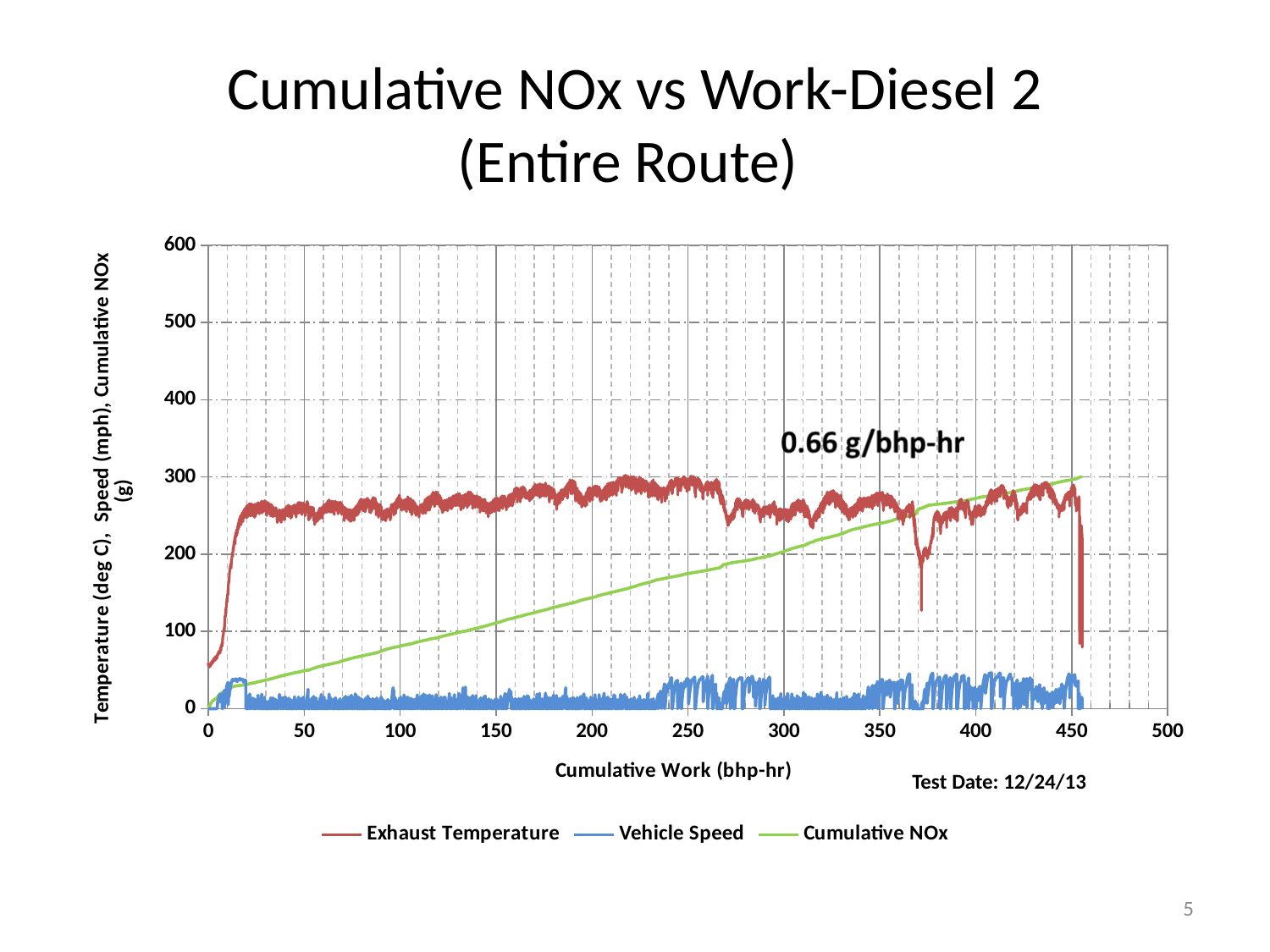
At 100 bhp-hr, which is larger: Exhaust Temperature or Cumulative NOx? Exhaust Temperature Is the Cumulative NOx value at 450 bhp-hr greater or less than 200? greater Is the Exhaust Temperature value at 100 bhp-hr greater or less than 200? greater At 450 bhp-hr, which is larger: Cumulative NOx or Vehicle Speed? Cumulative NOx Is the Vehicle Speed value at 100 bhp-hr greater or less than 100? less What are the three series listed in the legend? Exhaust Temperature, Vehicle Speed, Cumulative NOx Does the Cumulative NOx series rise or fall as cumulative work increases? Rises How many series does the legend list? 3 What kind of chart is shown on the slide? Line chart What is the label of the x axis? Cumulative Work (bhp-hr)